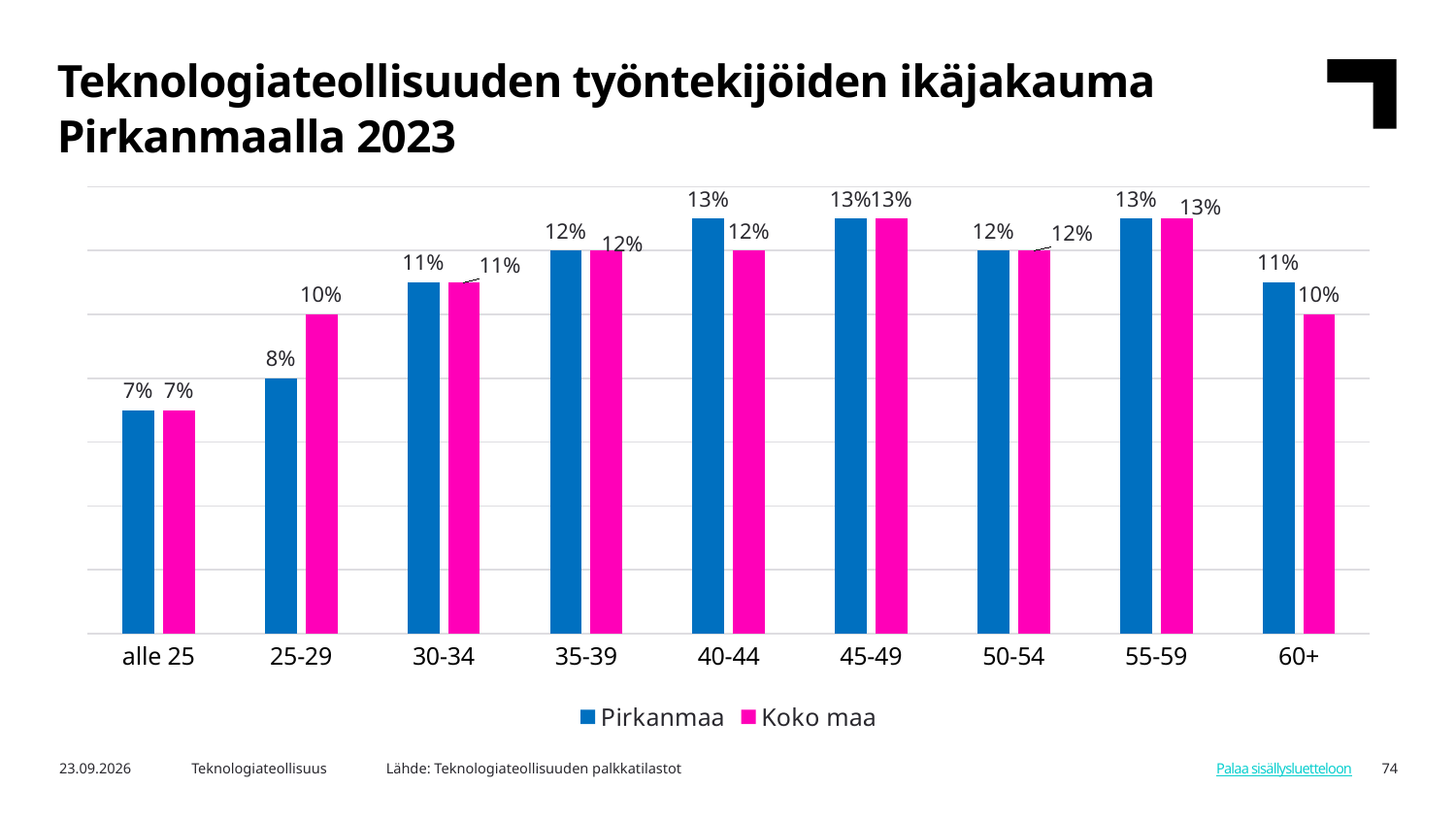
What is the difference between the Koko maa and Pirkanmaa values for the 25-29 age group? 2 percentage points How many series does the legend list? 2 How many age groups are shown on the x axis? 9 For the 25-29 age group, which series has the larger value, Pirkanmaa or Koko maa? Koko maa For the 60+ age group, which series has the larger value, Pirkanmaa or Koko maa? Pirkanmaa Which age group has the lowest Pirkanmaa value? alle 25 What is the Koko maa value for the 25-29 age group? 10% What kind of chart is shown on the slide? Bar chart What is the Pirkanmaa value for the 25-29 age group? 8% What is the Pirkanmaa value for the 40-44 age group? 13% Which age group has the lowest Koko maa value? alle 25 What is the Koko maa value for the 60+ age group? 10%